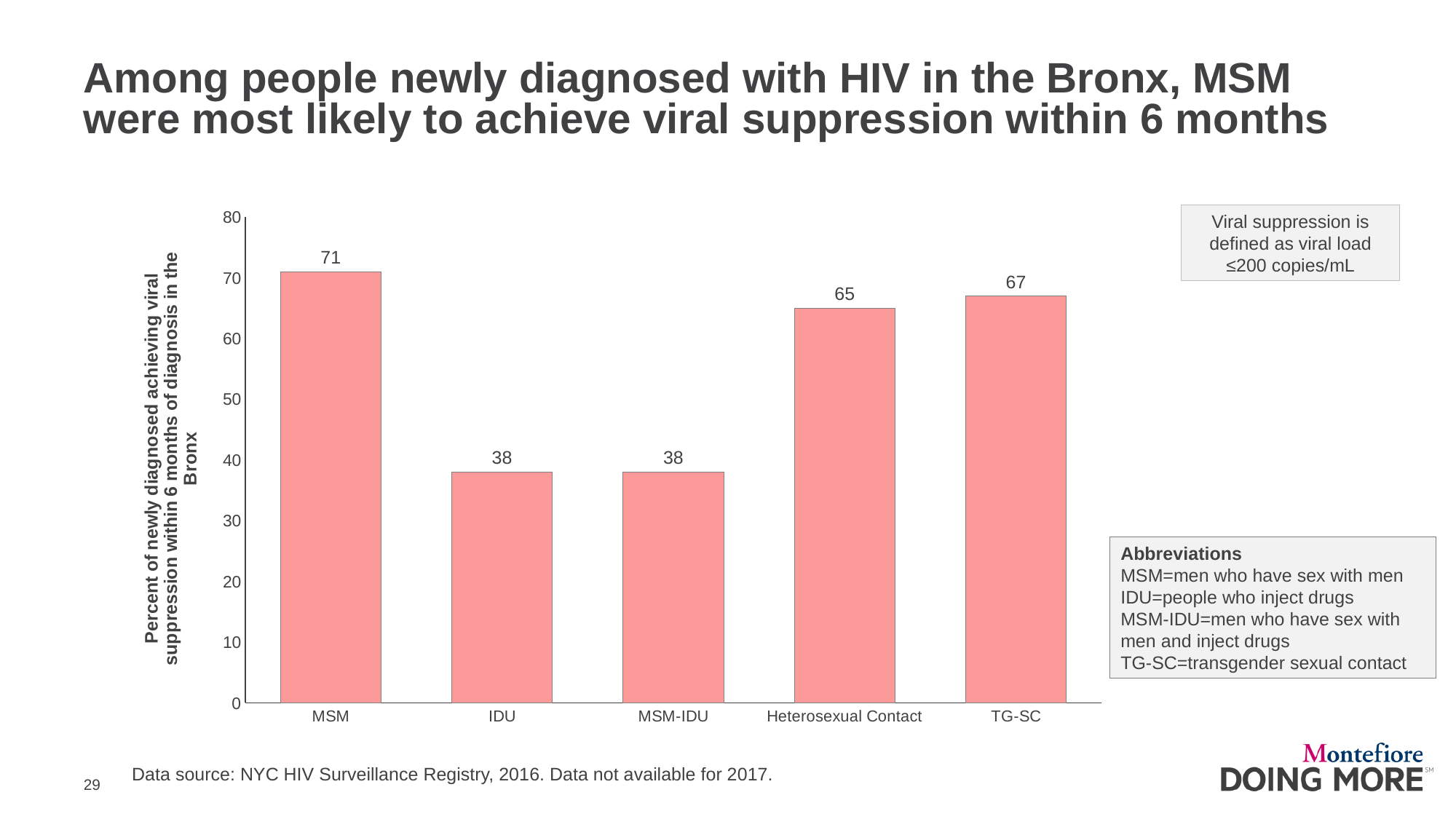
Is the value for MSM-IDU greater or less than 40? less What is the difference between the TG-SC value and the Heterosexual Contact value? 2 What percent of newly diagnosed MSM achieved viral suppression within 6 months? 71 What kind of chart is shown on the slide? bar chart What is the difference between the MSM value and the IDU value? 33 Which category has the highest percent achieving viral suppression? MSM What is the value shown for Heterosexual Contact? 65 Which is larger, the value for TG-SC or the value for Heterosexual Contact? TG-SC What is the value shown for IDU? 38 What is the maximum value shown on the y axis? 80 How many categories are shown on the x axis? 5 What is the value shown for TG-SC? 67